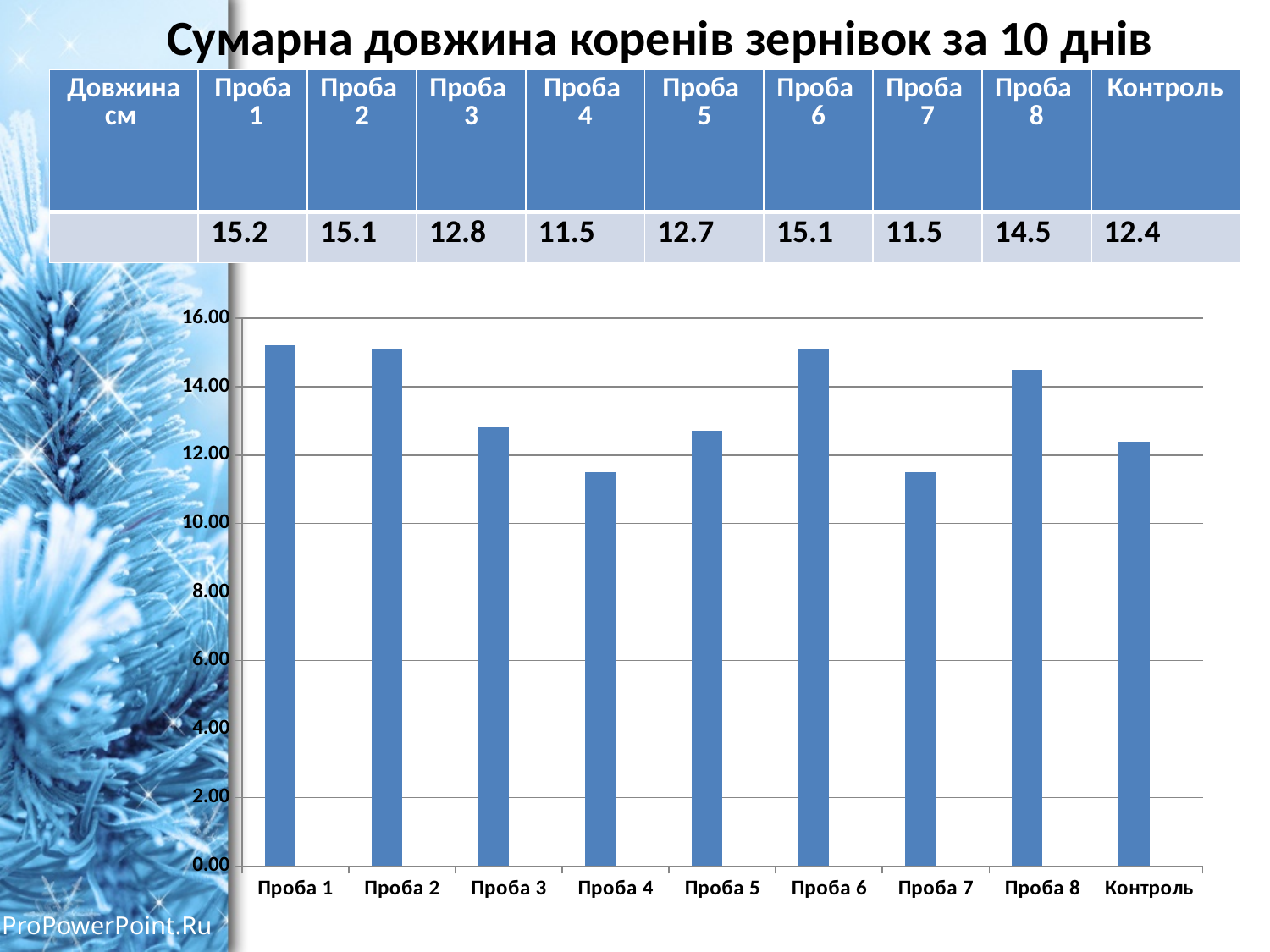
What is the difference between the values for Проба 8 and Контроль? 2.1 What is the value for Проба 1? 15.2 What is the value for Проба 5? 12.7 Is the value for Проба 8 greater or less than 14.00? greater What is the difference between the values for Проба 1 and Проба 4? 3.7 What is the value for Проба 8? 14.5 What is the value for Контроль? 12.4 How many categories are shown on the x axis of the chart? 9 Which is larger, the value for Проба 6 or the value for Контроль? Проба 6 Is the value for Проба 4 greater or less than 12.00? less What kind of chart is shown on the slide? bar chart Which is larger, the value for Проба 3 or the value for Проба 7? Проба 3